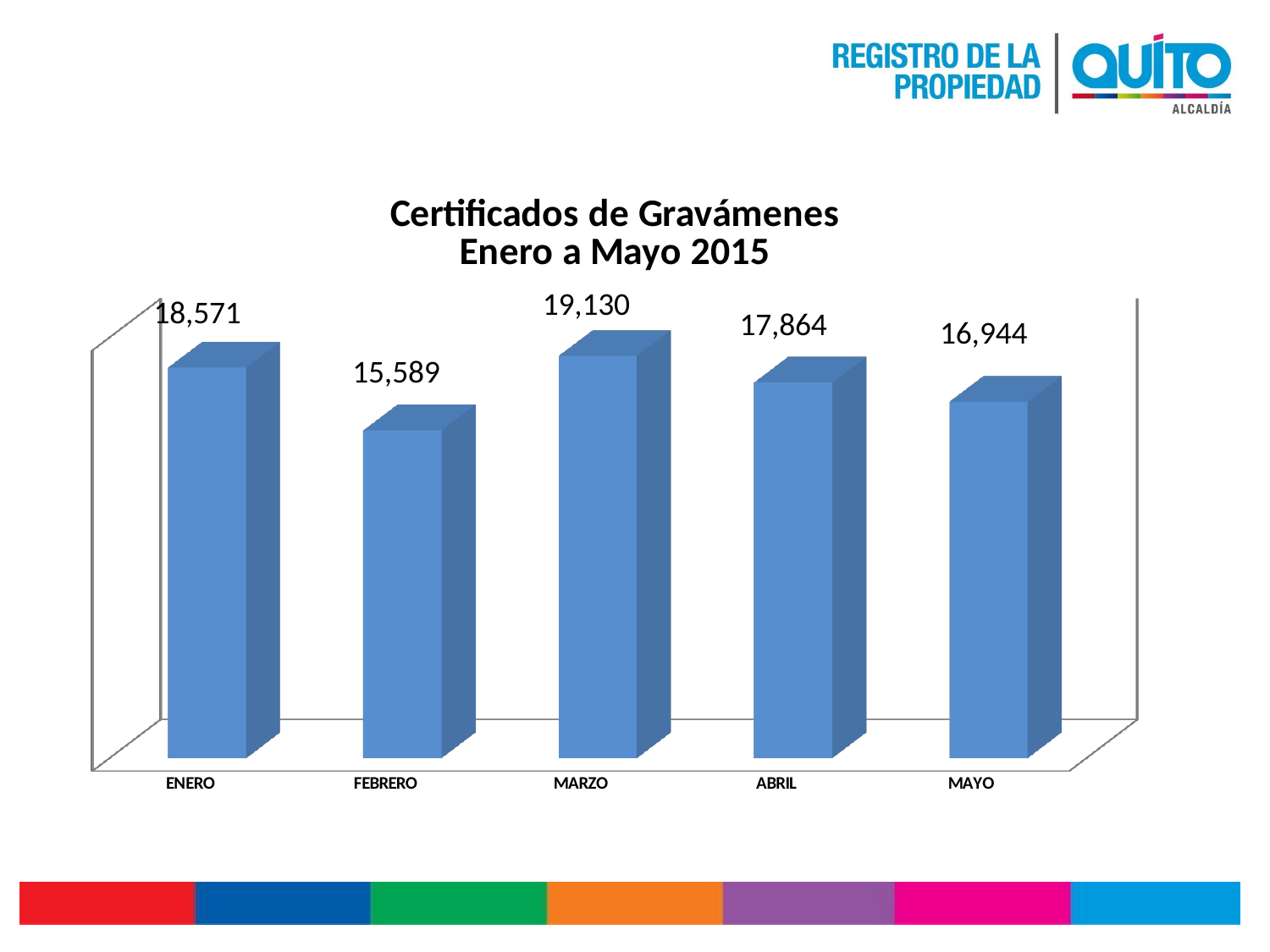
How many months are shown on the chart? 5 Which month has the highest value? MARZO What is the title of the chart? Certificados de Gravámenes Enero a Mayo 2015 Which month has the lowest value? FEBRERO What is the difference between the values for MARZO and FEBRERO? 3,541 What is the value for MARZO? 19,130 What kind of chart is shown on the slide? Bar chart What is the difference between the values for ENERO and MAYO? 1,627 What is the value for MAYO? 16,944 Do the values rise or fall from MARZO to MAYO? Fall Which is larger, the value for ABRIL or the value for MAYO? ABRIL What is the value for FEBRERO? 15,589